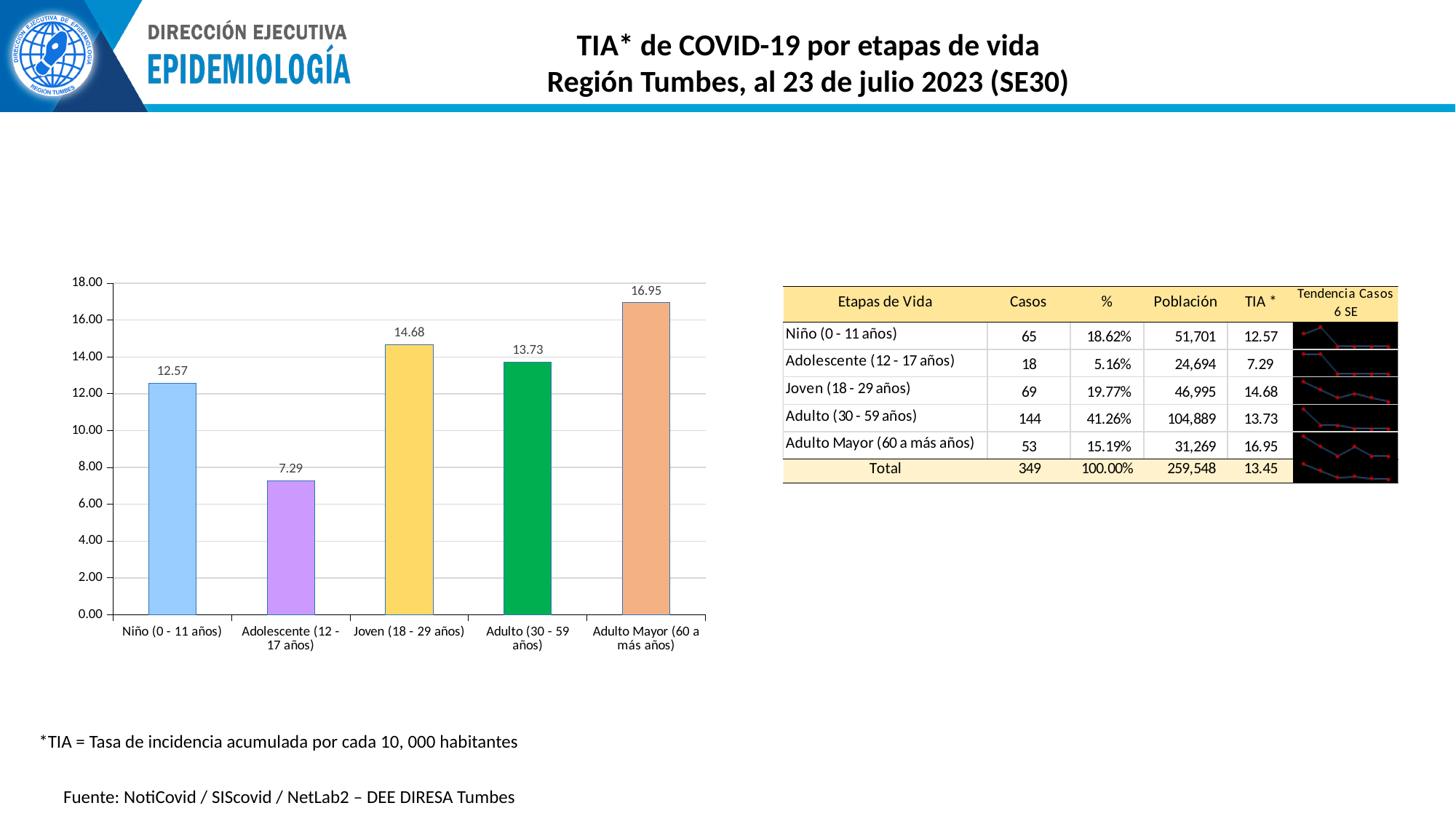
What is the TIA value for Adolescente (12 - 17 años) in the bar chart? 7.29 Which has a higher TIA: Joven (18 - 29 años) or Adulto (30 - 59 años)? Joven (18 - 29 años) Which age group has the highest TIA in the bar chart? Adulto Mayor (60 a más años) Which age group has the lowest TIA in the bar chart? Adolescente (12 - 17 años) What is the TIA value for Joven (18 - 29 años) in the bar chart? 14.68 What is the difference between the TIA for Adulto Mayor (60 a más años) and Adolescente (12 - 17 años)? 9.66 What type of chart is used to show TIA by age group? bar chart Is the TIA value for Adulto (30 - 59 años) greater or less than 12.00? greater How many age groups are shown in the bar chart? 5 What is the TIA value for Adulto Mayor (60 a más años) in the bar chart? 16.95 What colour is the bar for Adulto (30 - 59 años)? green What is the TIA value for Niño (0 - 11 años) in the bar chart? 12.57